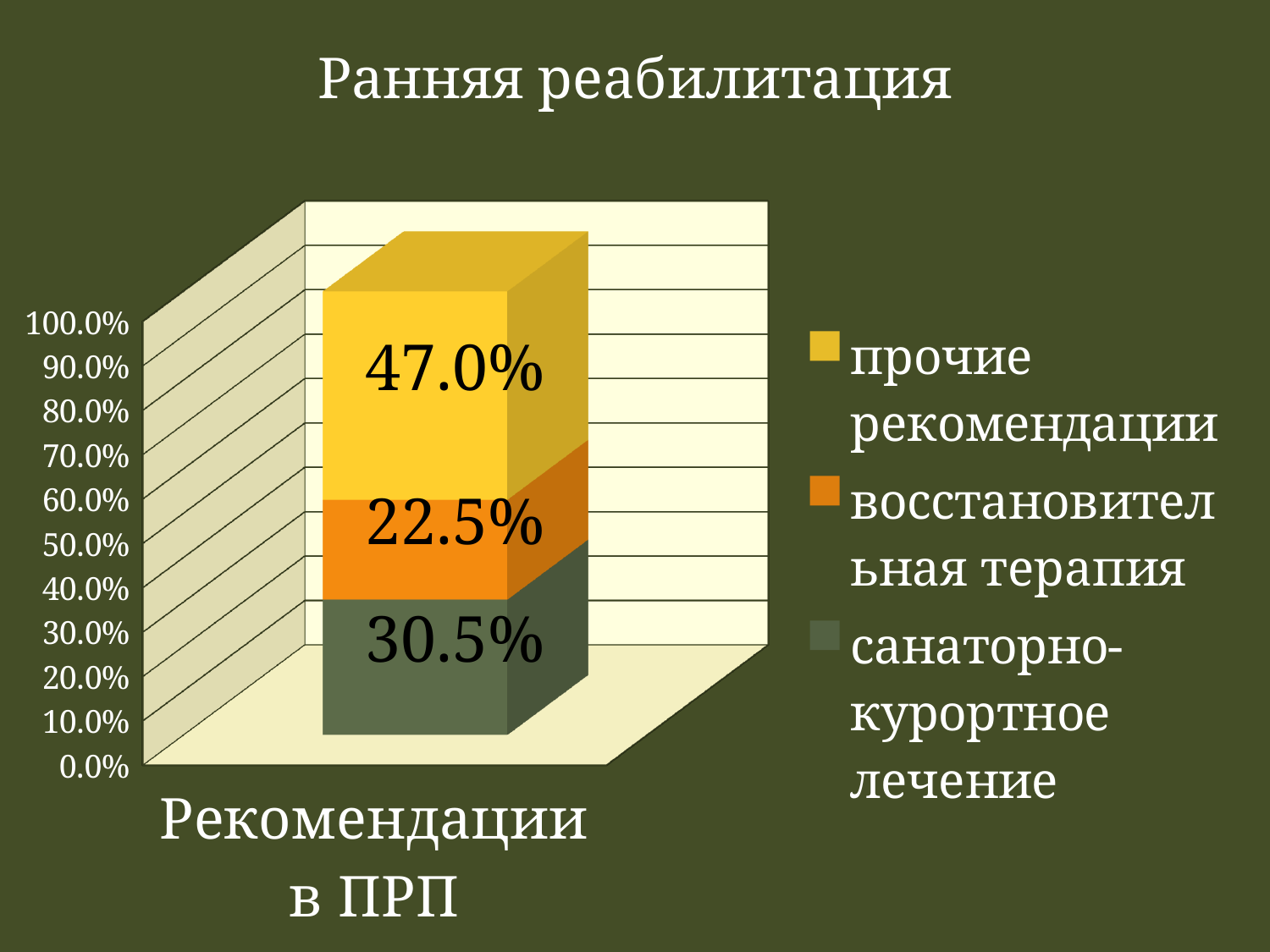
What is the difference between the values for 'прочие рекомендации' and 'санаторно-курортное лечение'? 16.5% What kind of chart is shown on the slide? stacked bar chart What is the value for 'санаторно-курортное лечение' in the 'Рекомендации в ПРП' bar? 30.5% What is the value for 'восстановительная терапия' in the 'Рекомендации в ПРП' bar? 22.5% Which series has the largest value in the 'Рекомендации в ПРП' bar? прочие рекомендации Which series has the smallest value in the 'Рекомендации в ПРП' bar? восстановительная терапия What is the difference between the values for 'санаторно-курортное лечение' and 'восстановительная терапия'? 8.0% How many series does the legend list? 3 Which is larger: the value for 'санаторно-курортное лечение' or the value for 'восстановительная терапия'? санаторно-курортное лечение What is the total of the stacked bar 'Рекомендации в ПРП'? 100.0% What is the title of the slide? Ранняя реабилитация What is the value for 'прочие рекомендации' in the 'Рекомендации в ПРП' bar? 47.0%